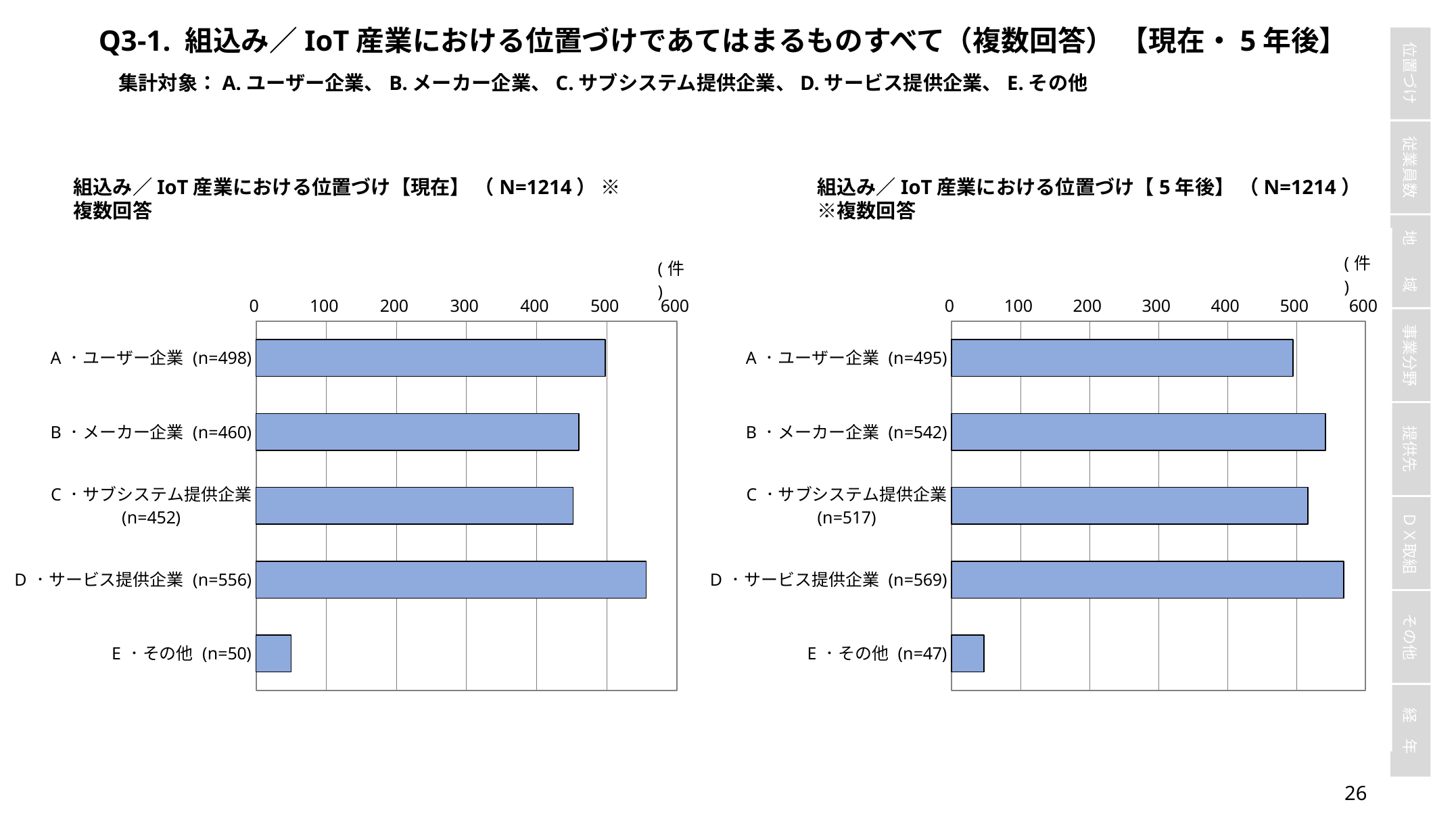
In the right chart (【5年後】), which category has the lowest value? E・その他 In the left chart (組込み／IoT産業における位置づけ【現在】), what is the value for A・ユーザー企業? 498 In the left chart (【現在】), what is the difference between D・サービス提供企業 and A・ユーザー企業? 58 In the left chart (【現在】), is the value for B・メーカー企業 greater or less than 400? greater In the right chart (【5年後】), which is larger, B・メーカー企業 or C・サブシステム提供企業? B・メーカー企業 How many categories are shown in the left chart (【現在】)? 5 In the right chart (組込み／IoT産業における位置づけ【5年後】), what is the value for B・メーカー企業? 542 In the left chart (【現在】), which category has the highest value? D・サービス提供企業 What kind of chart is the right chart (【5年後】)? bar chart What is the N value shown in the title of the left chart (【現在】)? N=1214 In the right chart (【5年後】), what is the value for C・サブシステム提供企業? 517 In the right chart (【5年後】), what is the difference between D・サービス提供企業 and E・その他? 522